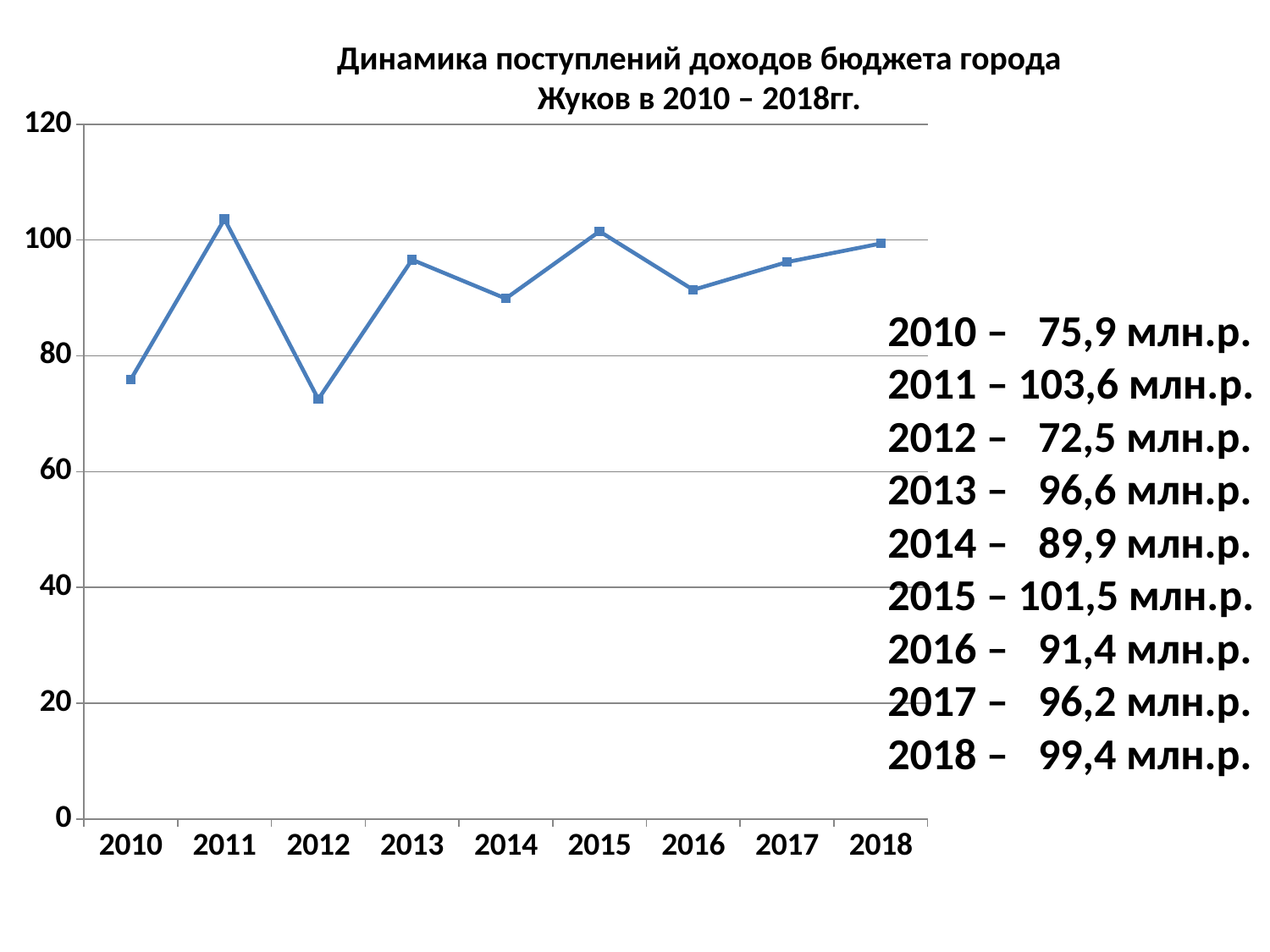
What is the budget revenue value for 2018? 99,4 млн.р. What is the difference between the values for 2018 and 2010? 23,5 млн.р. What is the budget revenue value for 2011? 103,6 млн.р. Which year has the larger value, 2015 or 2016? 2015 Does the value rise or fall from 2012 to 2013? rise How many years are plotted on the chart? 9 What type of chart is shown on the slide? Line chart Which year has the lowest budget revenue? 2012 Is the value for 2010 greater or less than 80? less Which year has the highest budget revenue? 2011 What is the budget revenue value for 2014? 89,9 млн.р. What is the difference between the values for 2011 and 2012? 31,1 млн.р.